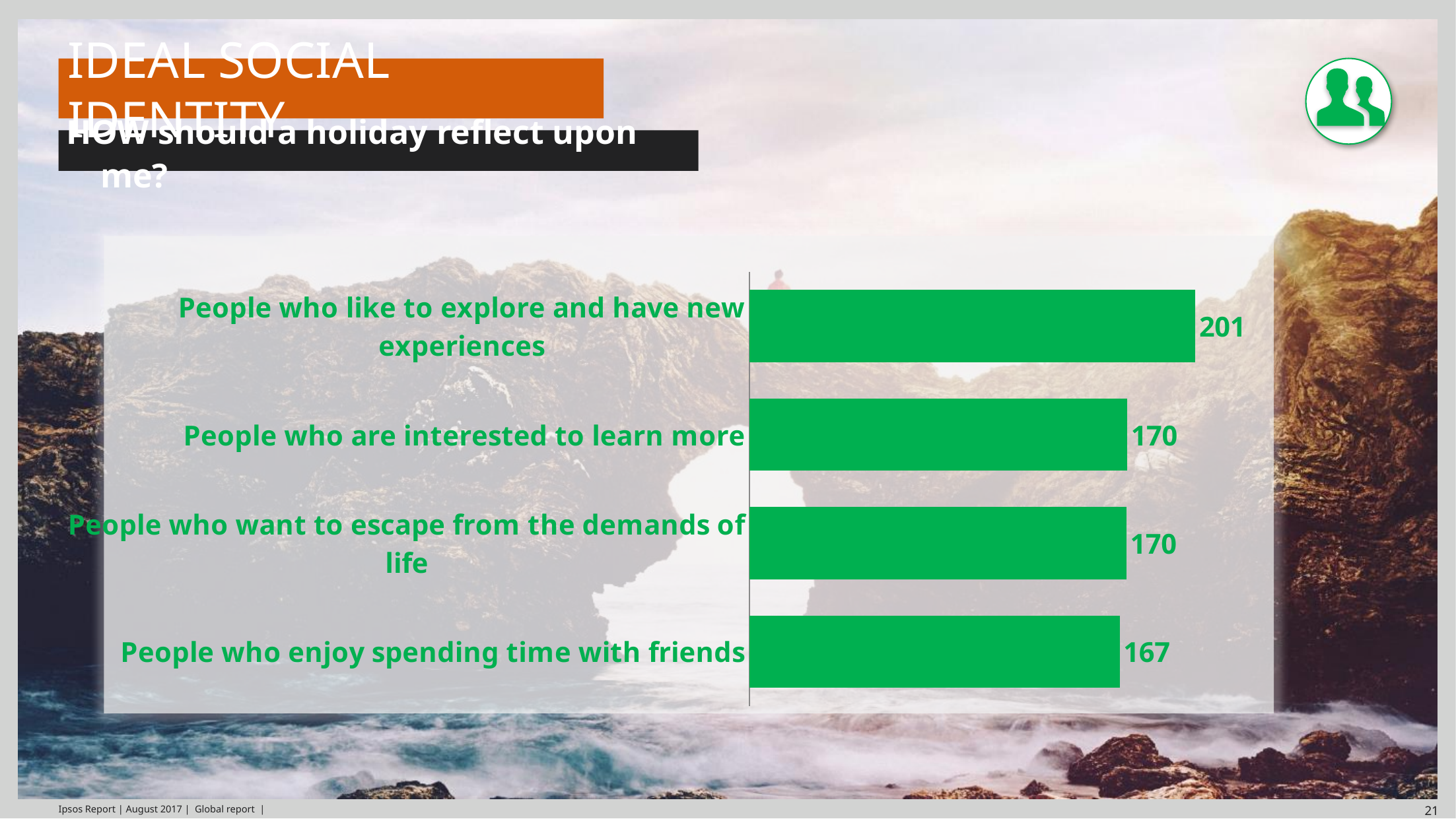
What is the value for 'People who are interested to learn more'? 170 What is the value for 'People who want to escape from the demands of life'? 170 How many categories are shown in the chart? 4 What is the difference between the values for 'People who are interested to learn more' and 'People who enjoy spending time with friends'? 3 What kind of chart is shown on the slide? Bar chart Which category has the lowest value? People who enjoy spending time with friends What is the value for 'People who enjoy spending time with friends'? 167 What is the difference between the values for 'People who like to explore and have new experiences' and 'People who enjoy spending time with friends'? 34 Which is larger: the value for 'People who like to explore and have new experiences' or 'People who are interested to learn more'? People who like to explore and have new experiences What is the value for 'People who like to explore and have new experiences'? 201 What colour are the bars in the chart? Green Which category has the highest value? People who like to explore and have new experiences